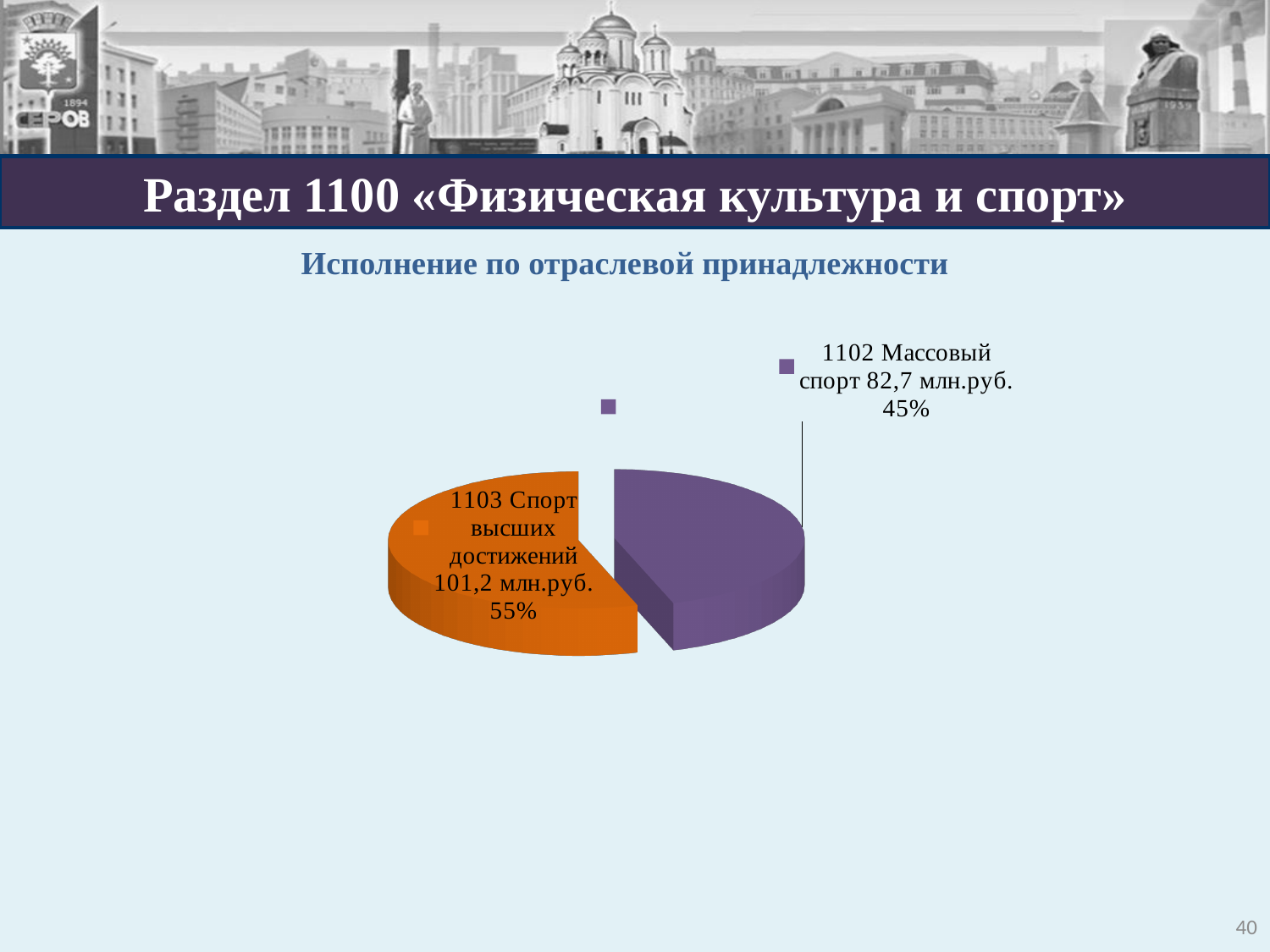
What colour is the slice for 1103 Спорт высших достижений? Orange What is the value shown for 1102 Массовый спорт? 82,7 млн.руб. How many slices does the pie chart have? 2 What is the difference between the values for 1103 Спорт высших достижений and 1102 Массовый спорт? 18,5 млн.руб. What share of the pie does 1102 Массовый спорт represent? 45% What is the value shown for 1103 Спорт высших достижений? 101,2 млн.руб. Which category has the largest slice of the pie? 1103 Спорт высших достижений What is the title of the chart? Исполнение по отраслевой принадлежности Which is larger: the value for 1102 Массовый спорт or for 1103 Спорт высших достижений? 1103 Спорт высших достижений Which category has the smallest slice of the pie? 1102 Массовый спорт What kind of chart is shown on the slide? Pie chart What share of the pie does 1103 Спорт высших достижений represent? 55%